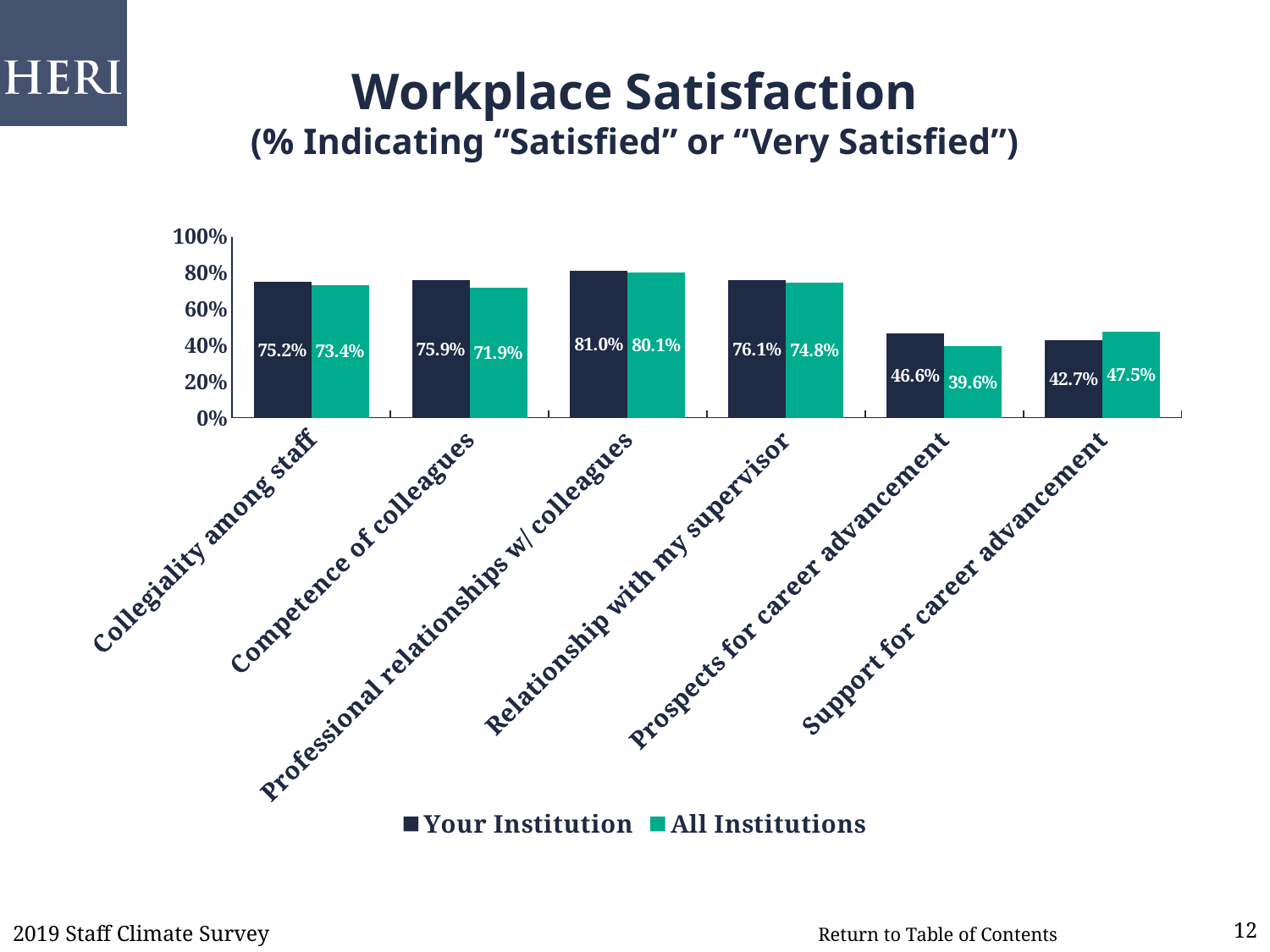
What is the value for All Institutions for Prospects for career advancement? 39.6% What is the title of the chart? Workplace Satisfaction Which category has the highest value for Your Institution? Professional relationships w/ colleagues What is the value for Your Institution for Relationship with my supervisor? 76.1% What kind of chart is shown on the slide? Bar chart Which category has the lowest value for All Institutions? Prospects for career advancement What is the value for Your Institution for Collegiality among staff? 75.2% Is the value for All Institutions for Prospects for career advancement greater or less than 40%? less What is the difference between Your Institution and All Institutions for Competence of colleagues? 4.0% How many categories are shown on the x axis? 6 How many series does the legend list? 2 For Support for career advancement, which is larger: Your Institution or All Institutions? All Institutions